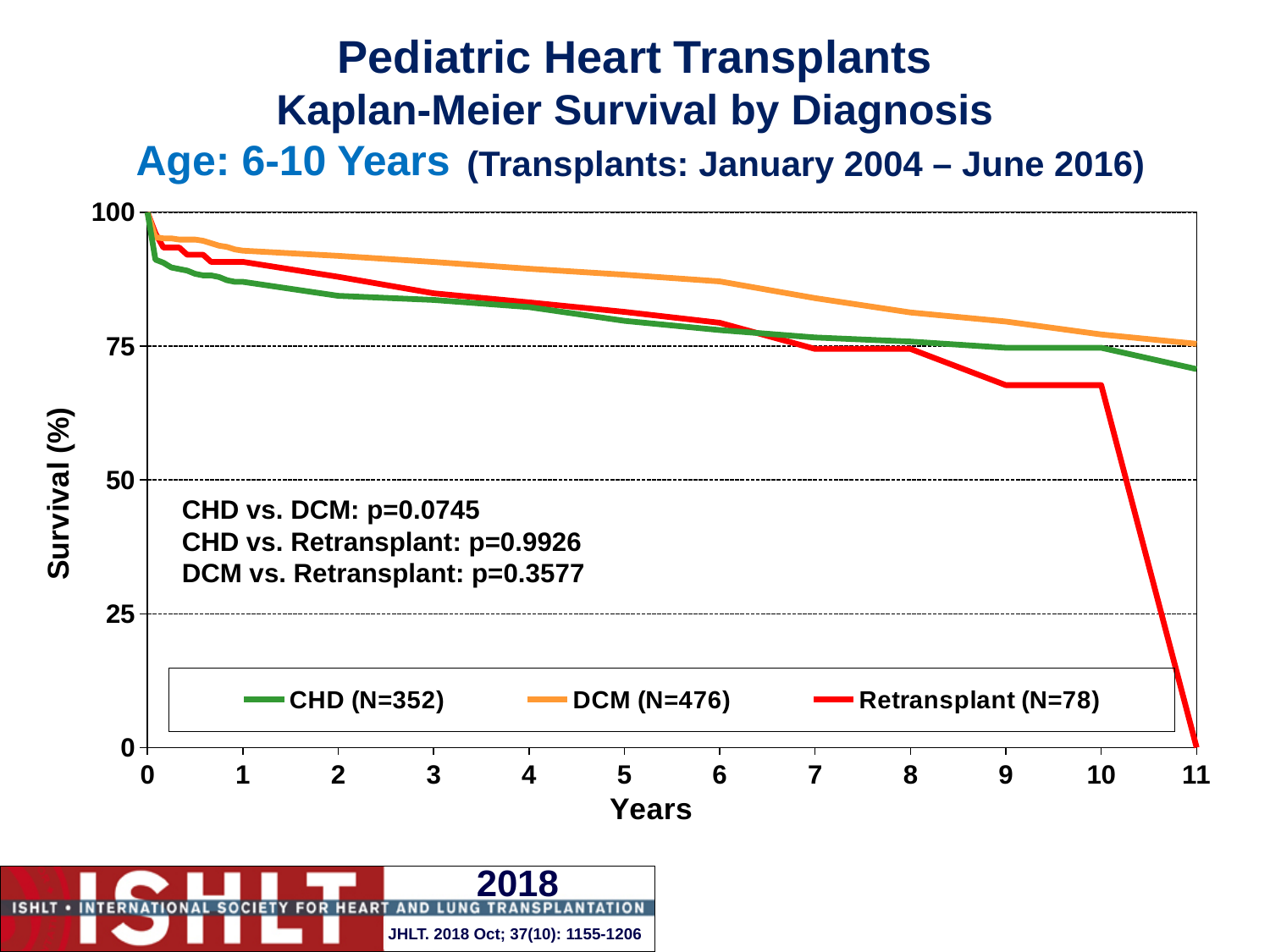
Is the survival for Retransplant at 9 years greater or less than 75? less What is the survival value for Retransplant at 11 years? 0 Is the survival for CHD at 11 years greater or less than 75? less Which series has the highest survival at 5 years? DCM (N=476) What is the N for the DCM series in the legend? 476 What kind of chart is shown on the slide? line chart Is the survival for DCM at 5 years greater or less than 75? greater Do the survival curves rise or fall as years increase? fall At 9 years, which has higher survival, CHD or Retransplant? CHD How many series does the legend list? 3 At 1 year, which has higher survival, Retransplant or CHD? Retransplant Which series has the lowest survival at 10 years? Retransplant (N=78)